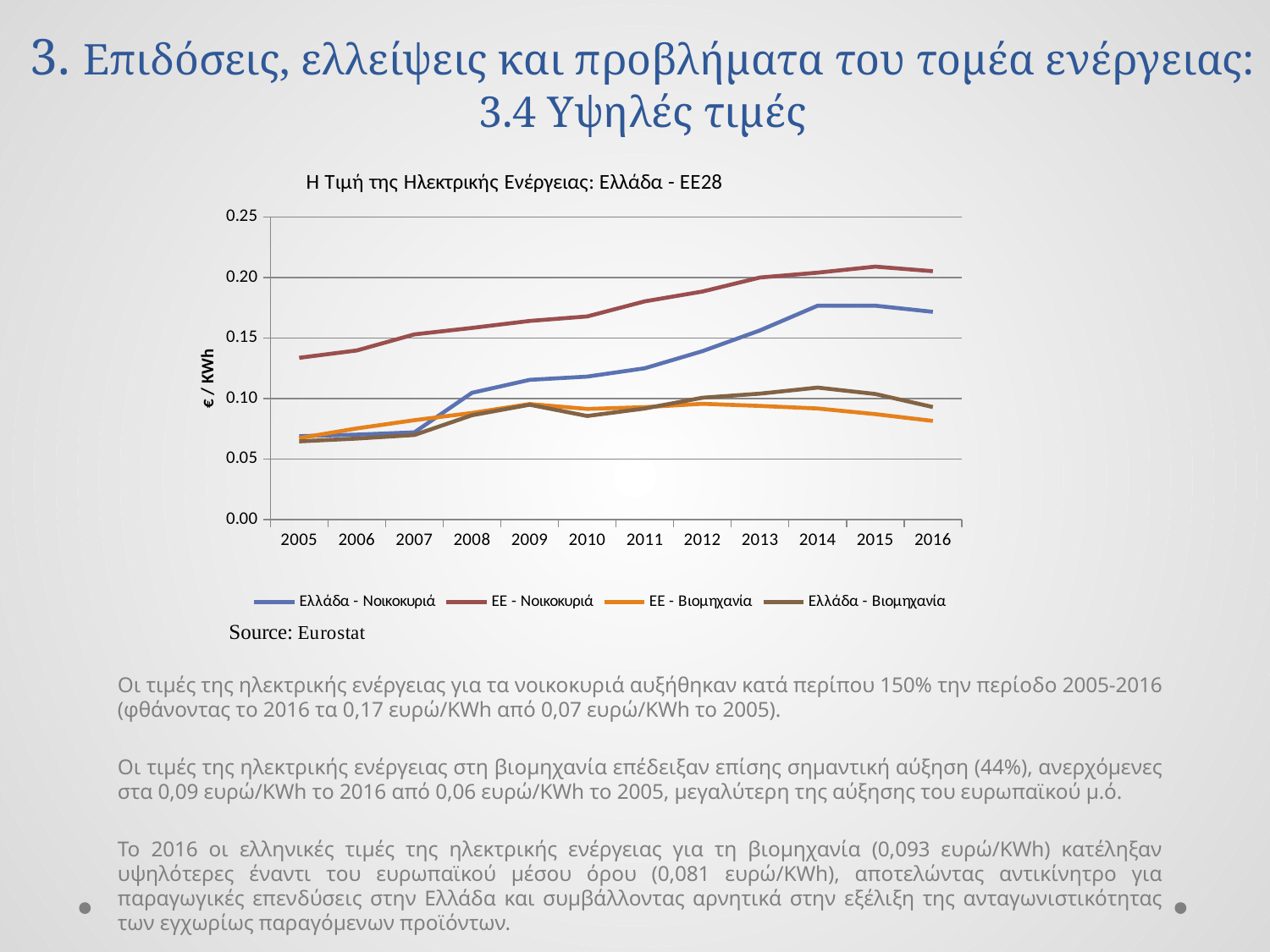
Does the ΕΕ - Νοικοκυριά series generally rise or fall from 2005 to 2015? Rise What kind of chart is shown on the slide? Line chart Which series has the lowest value in 2016? ΕΕ - Βιομηχανία How many years are plotted along the x axis of the chart? 12 Is the value for Ελλάδα - Νοικοκυριά in 2005 greater or less than 0.10? less Is the value for Ελλάδα - Νοικοκυριά in 2014 greater or less than 0.15? greater Which series has the highest value in 2016? ΕΕ - Νοικοκυριά Is the value for ΕΕ - Νοικοκυριά in 2015 greater or less than 0.20? greater What is the label on the y axis of the chart? € / KWh How many series does the chart legend list? 4 In 2010, which is larger: the value for Ελλάδα - Νοικοκυριά or for ΕΕ - Νοικοκυριά? ΕΕ - Νοικοκυριά In 2016, which is larger: the value for Ελλάδα - Βιομηχανία or for ΕΕ - Βιομηχανία? Ελλάδα - Βιομηχανία